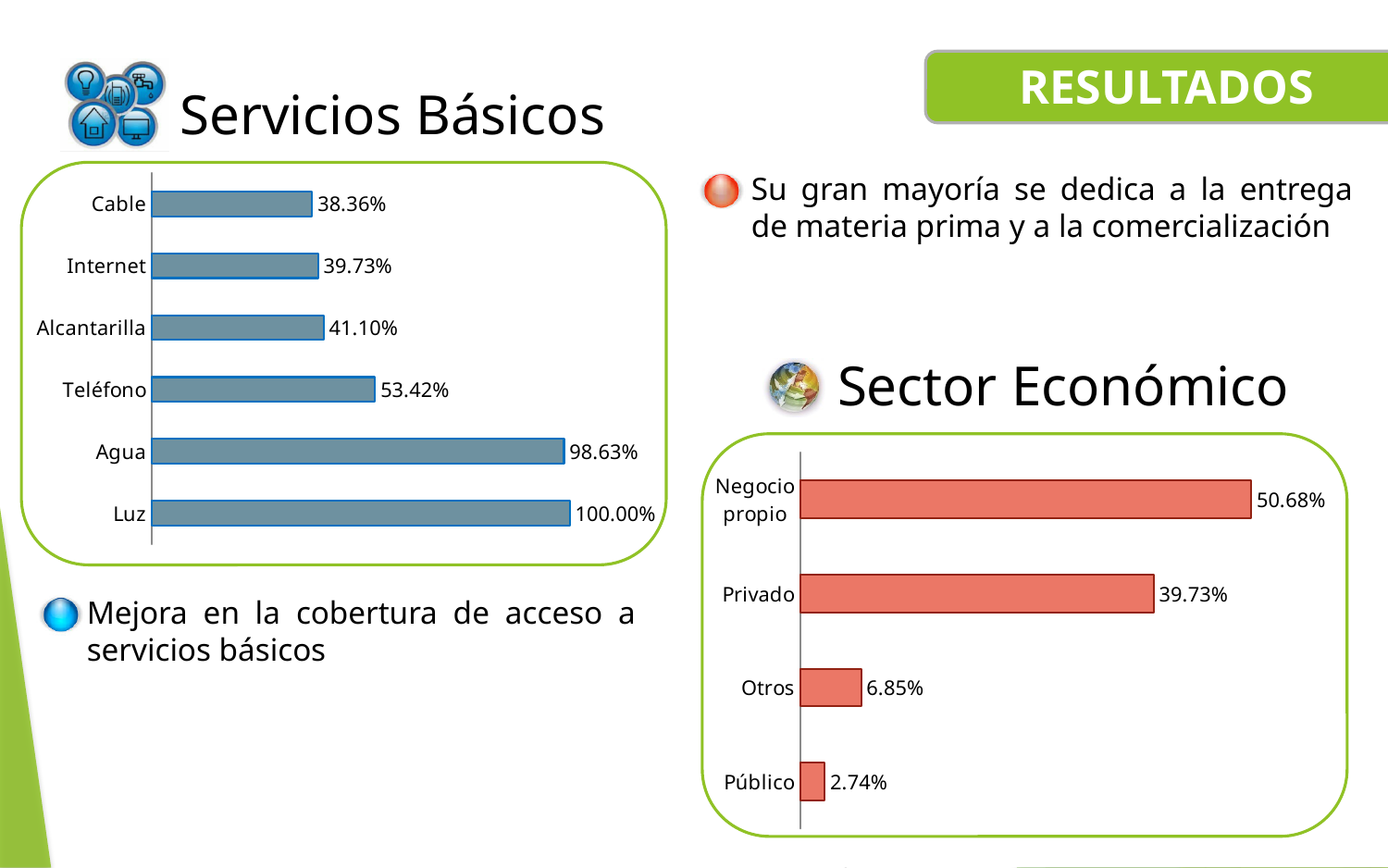
In the Servicios Básicos chart, what is the value for Teléfono? 53.42% How many categories are shown in the Servicios Básicos chart? 6 In the Sector Económico chart, which category has the lowest value? Público In the Servicios Básicos chart, which category has the lowest value? Cable In the Sector Económico chart, which category has the highest value? Negocio propio What kind of chart is the Servicios Básicos chart? Bar chart In the Servicios Básicos chart, which category has the highest value? Luz How many categories are shown in the Sector Económico chart? 4 In the Sector Económico chart, what is the difference between the values for Negocio propio and Privado? 10.95% In the Sector Económico chart, what is the value for Privado? 39.73% In the Servicios Básicos chart, what is the difference between the values for Agua and Teléfono? 45.21% In the Servicios Básicos chart, which is larger, the value for Internet or the value for Alcantarilla? Alcantarilla